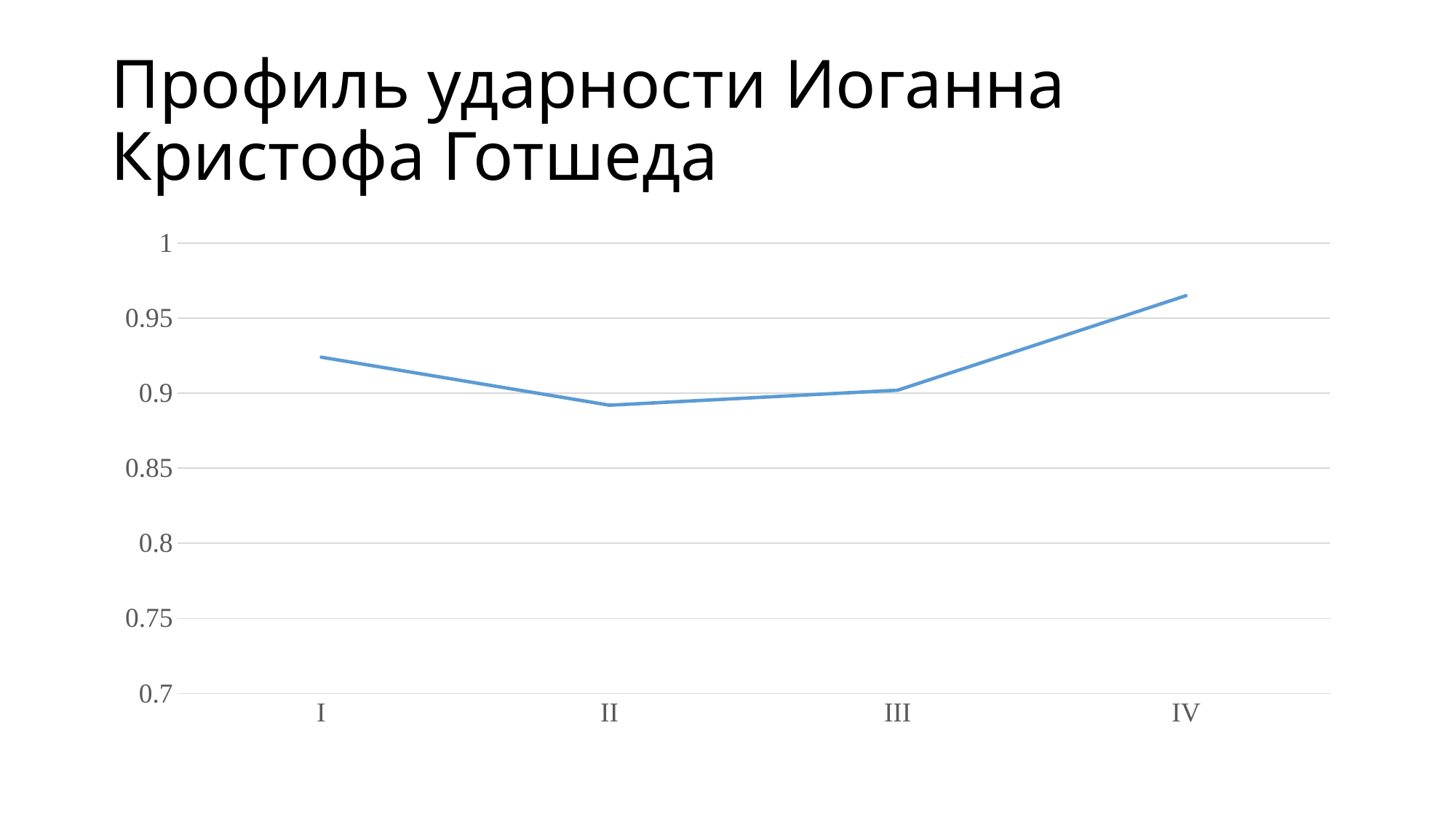
Is the value for I greater or less than 0.95? less Which category has the highest value? IV How many points are plotted along the x axis? 4 Which category has the lowest value? II What kind of chart is shown on the slide? line chart Is the value for I greater or less than 0.9? greater How many lines (series) are plotted on the chart? 1 Which is larger, the value for I or the value for III? I Which is larger, the value for IV or the value for I? IV Is the value for IV greater or less than 0.95? greater Does the line rise or fall from III to IV? rises What is the title of the slide? Профиль ударности Иоганна Кристофа Готшеда